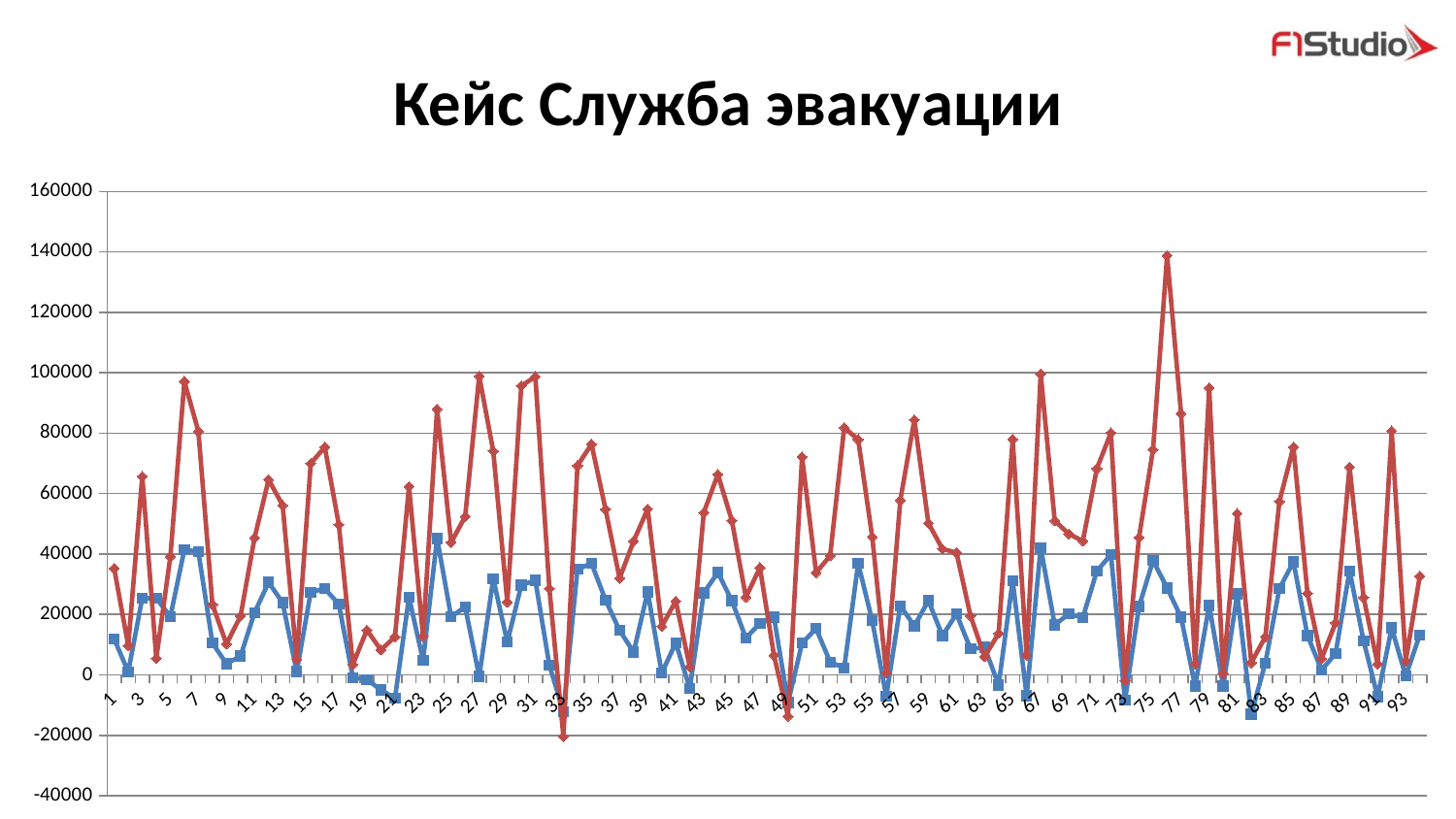
Which is larger for the red series: the value at point 77 or the value at point 67? point 67 What is the title of the chart? Кейс Служба эвакуации Which series has the larger value at point 33, the red or the blue? blue How many lines (series) are plotted on the chart? 2 At which x-axis point does the red series reach its highest value? 76 What is the highest value shown on the vertical axis? 160000 Is the value of the red series at point 33 greater or less than 0? less At which x-axis point does the red series reach its lowest value? 33 Is the value of the red series at point 77 greater or less than 120000? less What kind of chart is shown on the slide? line chart Is the value of the red series at point 1 greater or less than 20000? greater